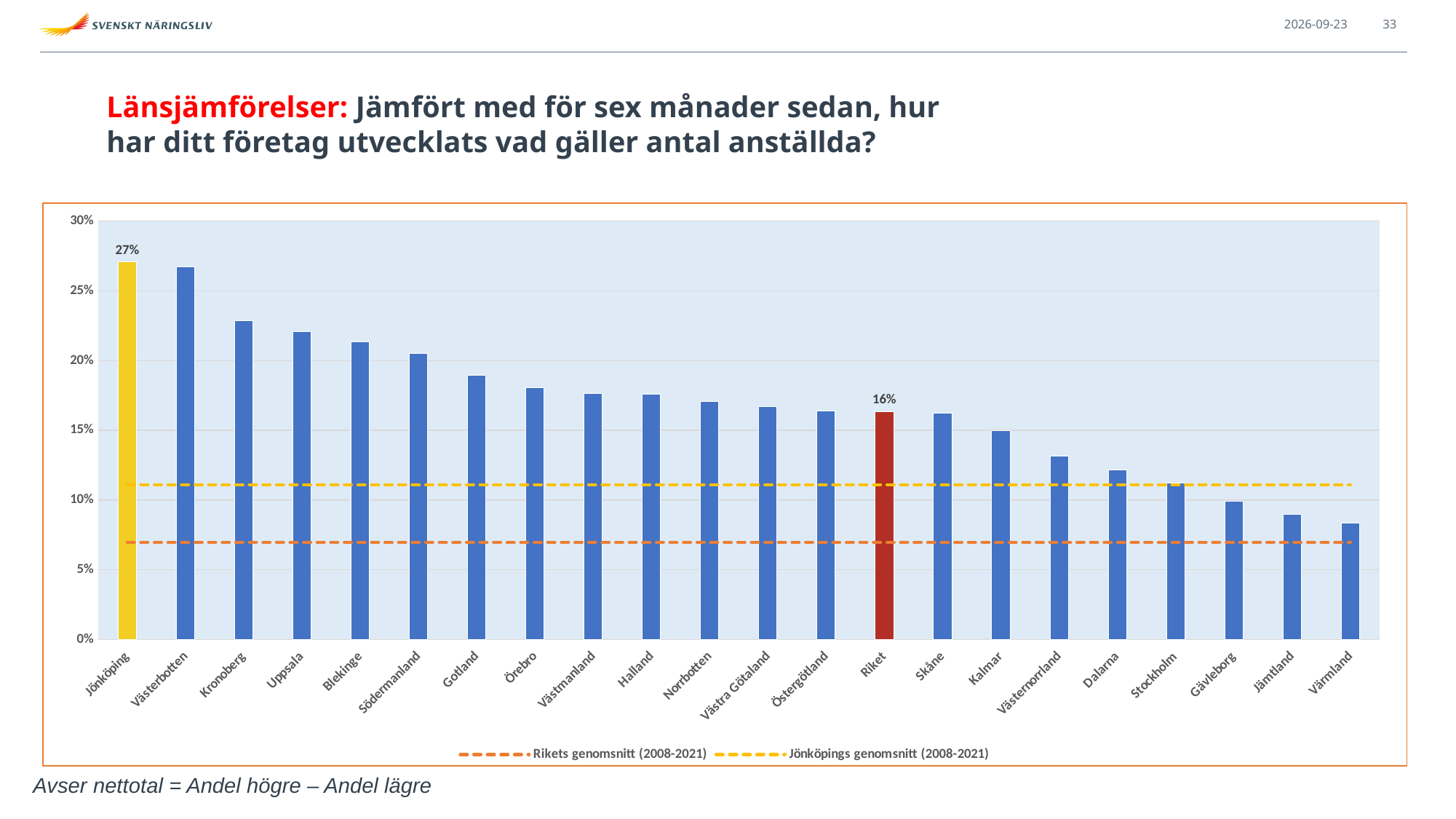
How many bars (categories) are shown on the x axis? 22 What is the difference between the values for Jönköping and Riket? 11 percentage points What is the value shown for Jönköping? 27% Which is larger, the value for Uppsala or the value for Skåne? Uppsala Is the value for Västernorrland greater or less than 15%? less Is the value for Kronoberg greater or less than 20%? greater Is the value for Gotland greater or less than 20%? less What kind of chart is shown on the slide? Bar chart Which county has the lowest bar in the chart? Värmland Which category has the highest bar in the chart? Jönköping Do the bar values rise or fall from left to right along the x axis? Fall What is the value shown for Riket? 16%